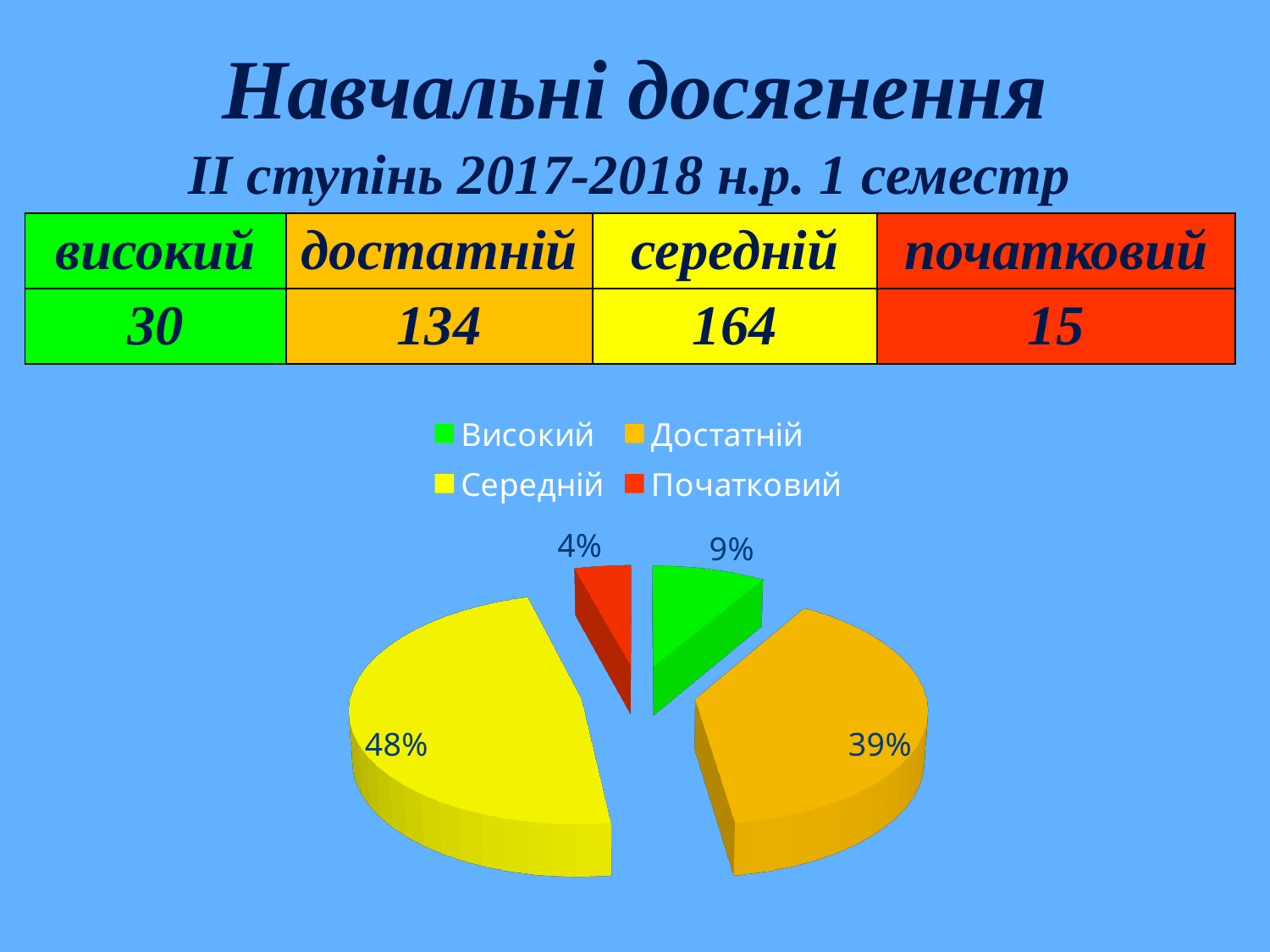
What kind of chart is shown on the slide? pie chart How many slices does the pie chart have? 4 What share of the pie does the Достатній slice represent? 39% Which is larger in the pie chart, the Достатній slice or the Високий slice? Достатній What share of the pie does the Середній slice represent? 48% What colour is the Початковий slice in the pie chart? red What share of the pie does the Високий slice represent? 9% Which slice of the pie chart is the largest? Середній How many entries does the chart legend list? 4 Which slice of the pie chart is the smallest? Початковий What is the difference in percentage points between the Середній slice and the Достатній slice? 9